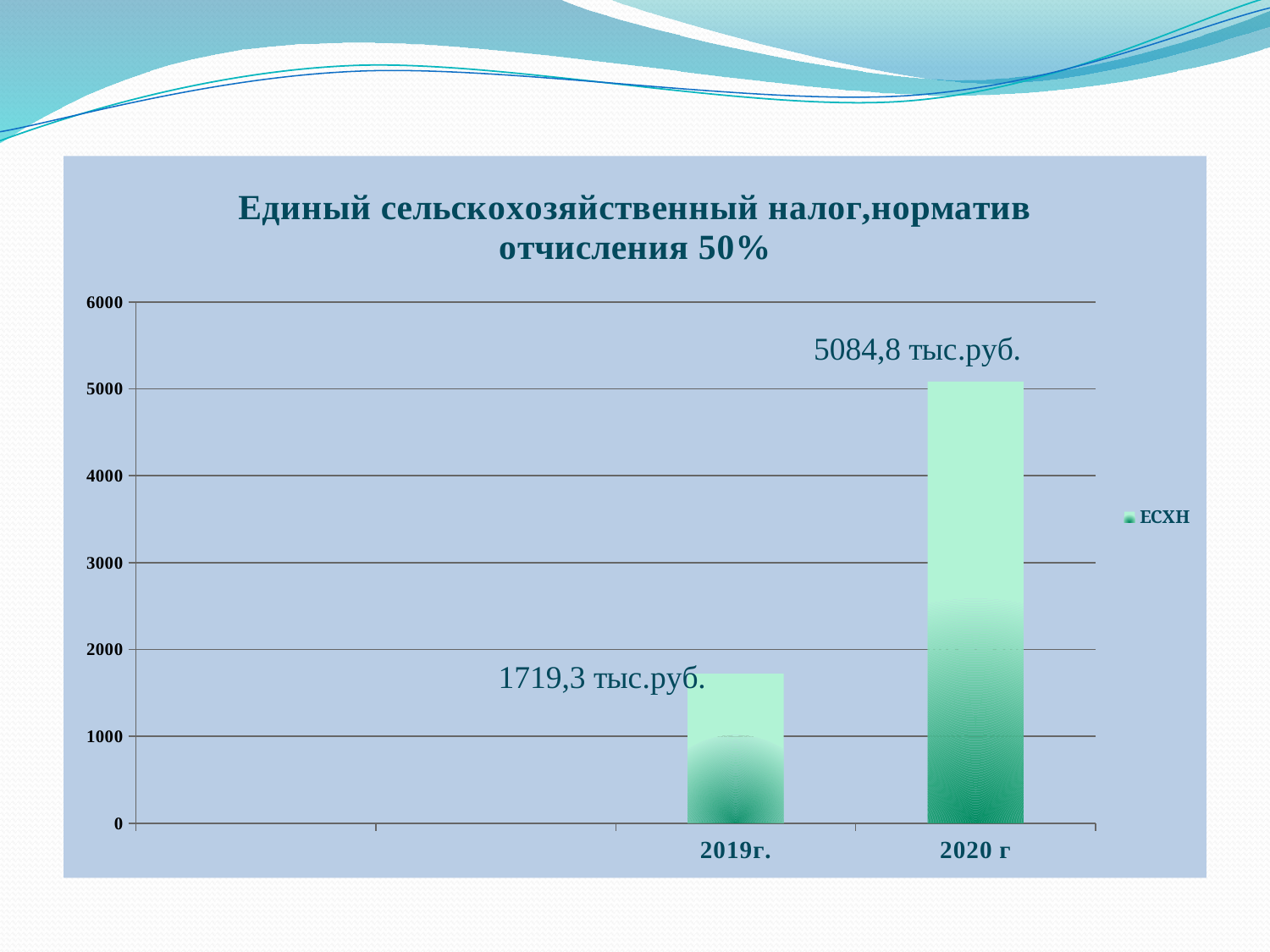
Do the values rise or fall from 2019г. to 2020 г? rise What is the difference between the values for 2020 г and 2019г.? 3365,5 тыс.руб. What is the value for 2020 г? 5084,8 тыс.руб. What kind of chart is shown? bar chart How many series does the legend list? 1 Is the value for 2020 г greater or less than 5000? greater What is the value for 2019г.? 1719,3 тыс.руб. Which year has the highest value? 2020 г Which year has the lowest value? 2019г. How many categories are shown on the x axis? 2 Is the value for 2019г. greater or less than 2000? less Which is larger, the value for 2019г. or the value for 2020 г? 2020 г